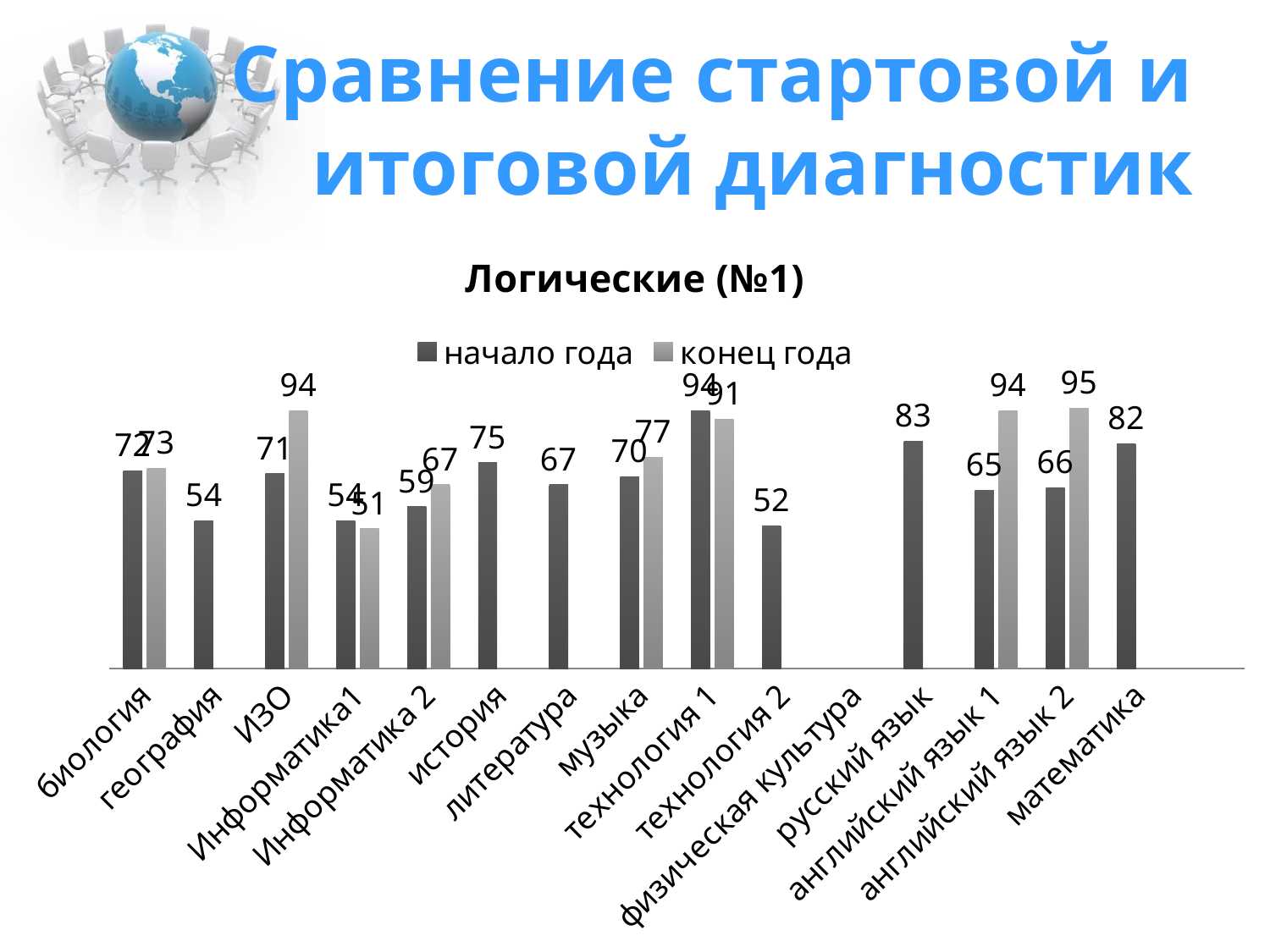
What kind of chart is shown on the slide? bar chart Which category has the highest value in the конец года series? английский язык 2 What is the value for ИЗО in the конец года series? 94 Which is larger for музыка: the начало года value or the конец года value? конец года Which category has the lowest value in the начало года series? технология 2 What is the value for русский язык in the начало года series? 83 What is the value for Информатика1 in the конец года series? 51 What is the difference between the начало года values for математика and география? 28 What is the title of the chart? Логические (№1) How many categories are shown on the x axis? 15 How many series does the legend list? 2 What is the difference between the конец года and начало года values for английский язык 1? 29